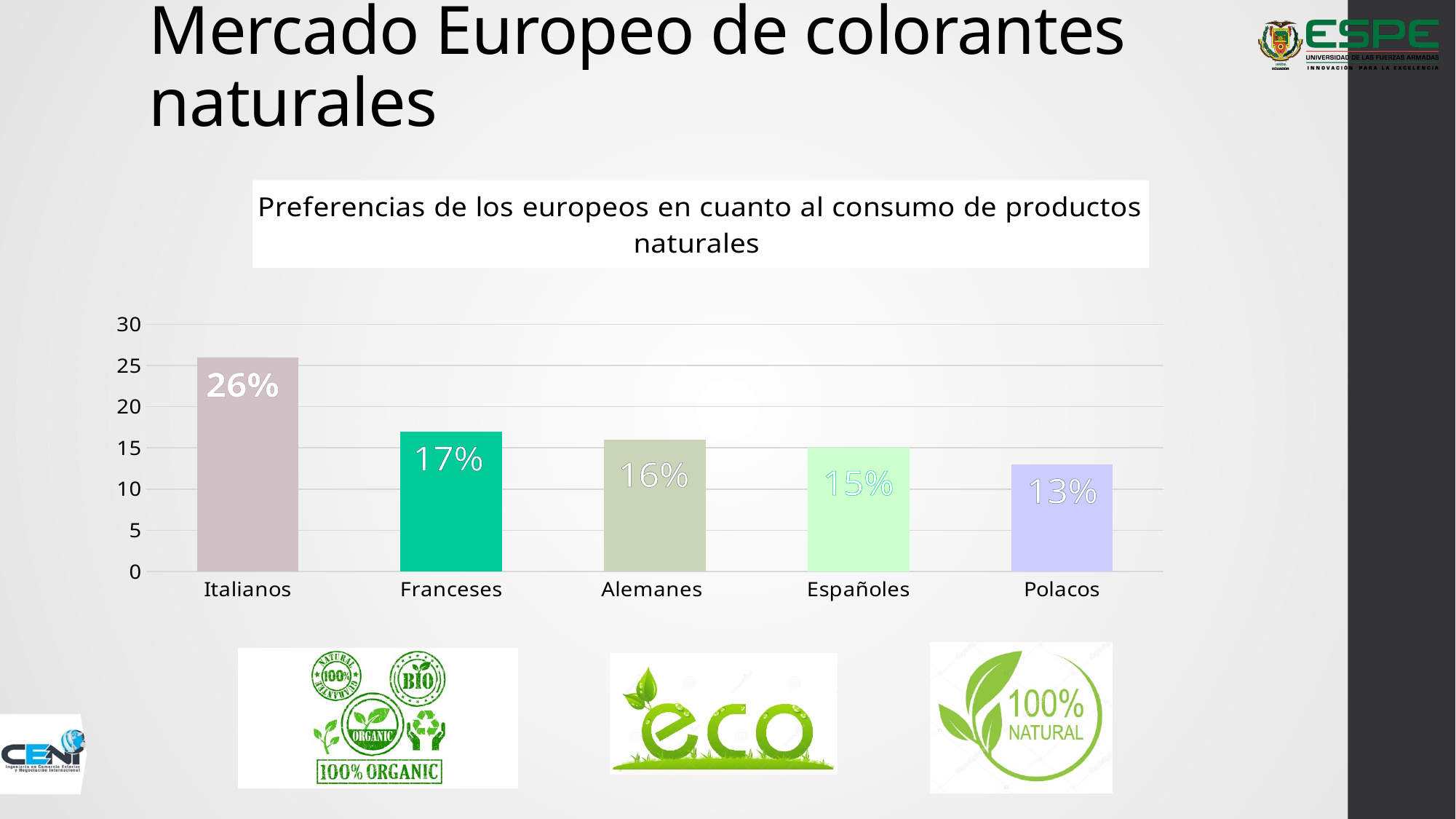
What is the value for Polacos? 13% What is the value for Italianos? 26% Which category has the highest value? Italianos Which is larger, the value for Franceses or the value for Polacos? Franceses What is the difference between the values for Italianos and Franceses? 9% Is the value for Italianos greater or less than 20? greater Which category has the lowest value? Polacos What kind of chart is shown on the slide? bar chart What is the title of the chart? Preferencias de los europeos en cuanto al consumo de productos naturales What is the value for Alemanes? 16% How many categories are shown on the x axis? 5 What is the difference between the values for Españoles and Polacos? 2%